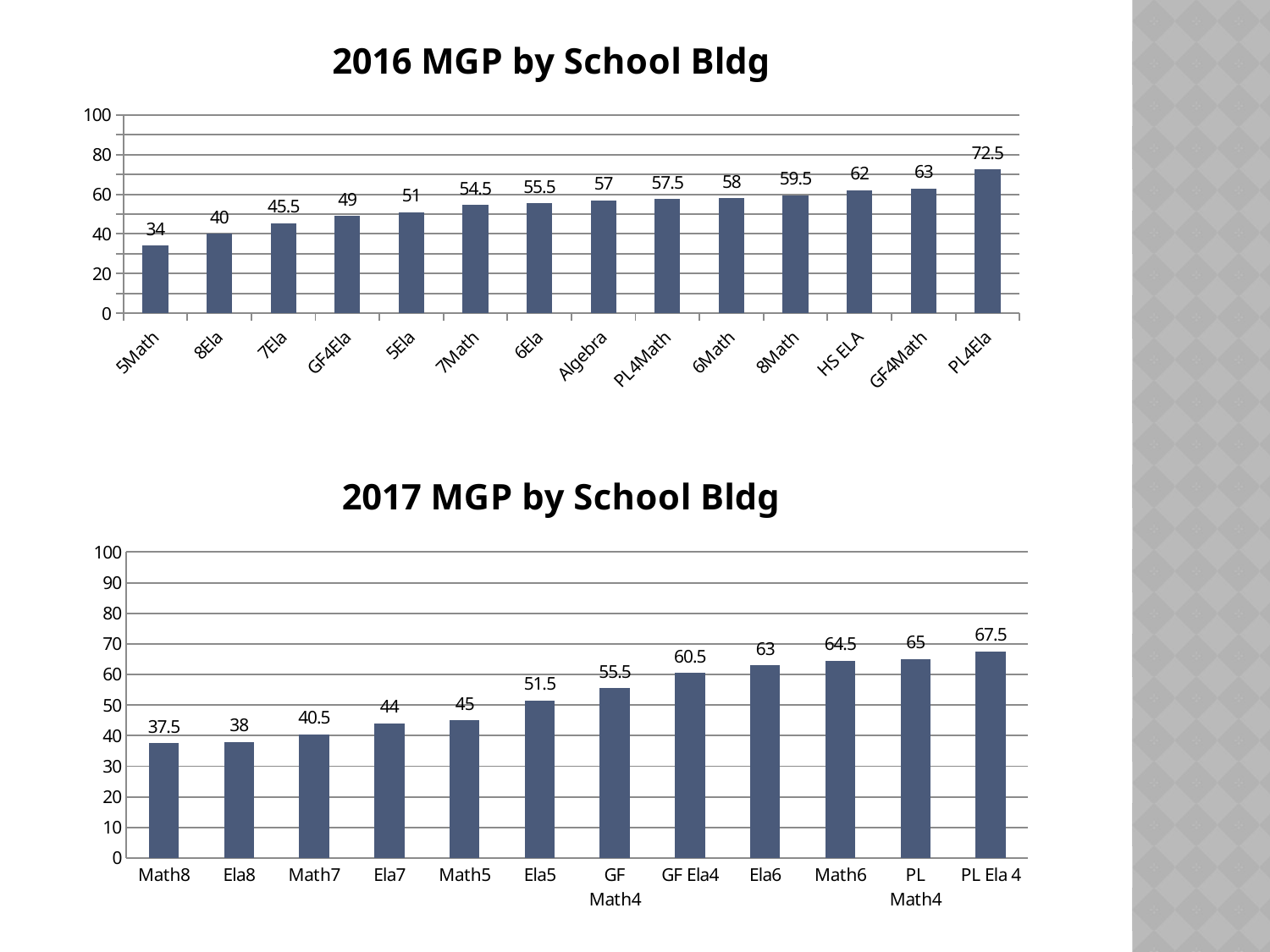
What kind of chart is the '2017 MGP by School Bldg' chart? Bar chart In the '2016 MGP by School Bldg' chart, which category has the lowest value? 5Math In the '2017 MGP by School Bldg' chart, how many categories are shown? 12 In the '2017 MGP by School Bldg' chart, what is the difference between the values for PL Ela 4 and Math8? 30 In the '2017 MGP by School Bldg' chart, what is the value for Ela5? 51.5 In the '2016 MGP by School Bldg' chart, how many categories are shown? 14 In the '2016 MGP by School Bldg' chart, which category has the highest value? PL4Ela In the '2017 MGP by School Bldg' chart, which is larger, the value for Math6 or the value for Ela6? Math6 In the '2016 MGP by School Bldg' chart, what is the value for 7Math? 54.5 In the '2016 MGP by School Bldg' chart, do the values rise or fall from left to right along the x axis? Rise In the '2017 MGP by School Bldg' chart, which category has the highest value? PL Ela 4 In the '2016 MGP by School Bldg' chart, what is the difference between the values for GF4Math and GF4Ela? 14